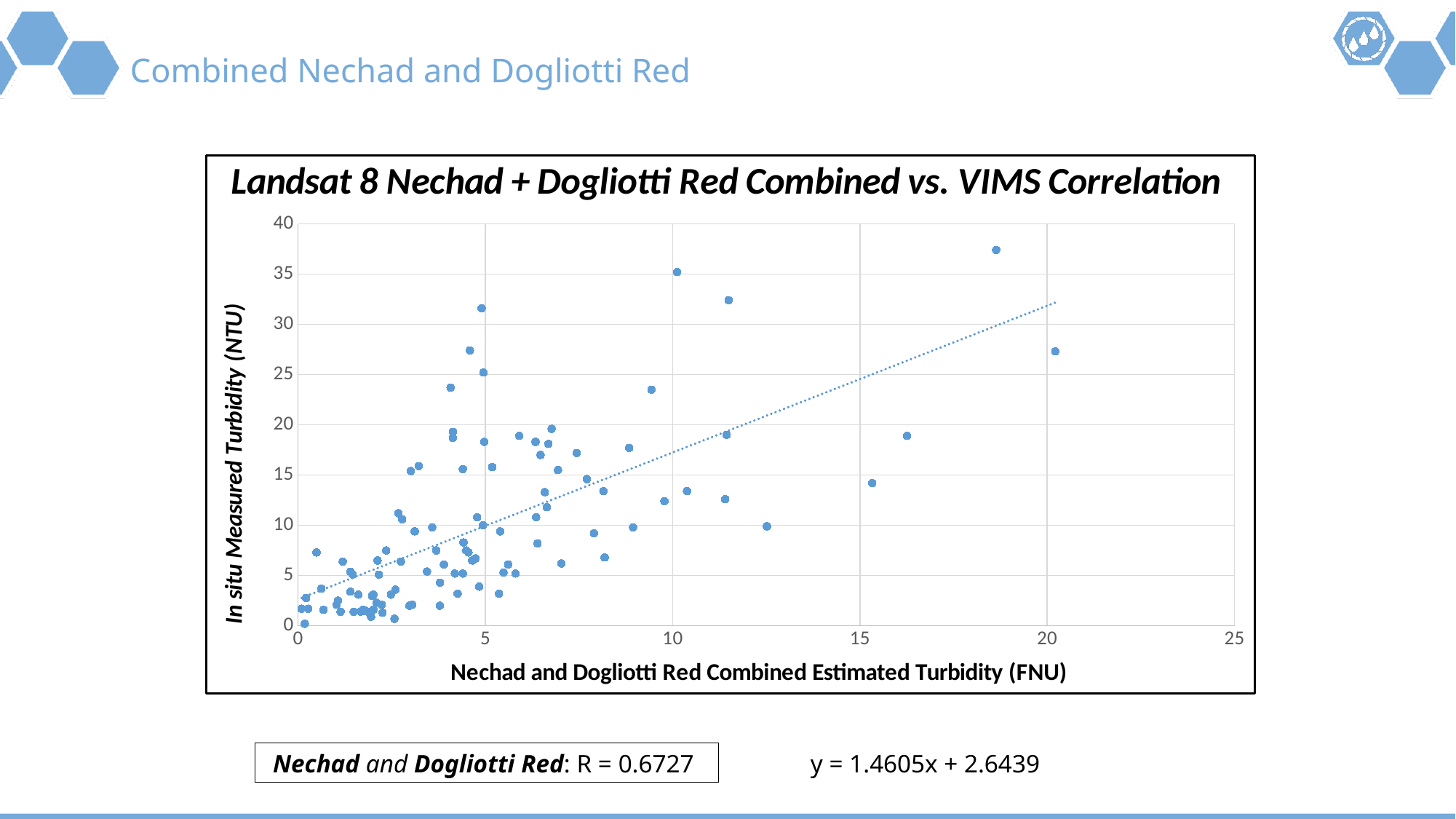
What is the maximum value shown on the y axis of the chart? 40 Does the dotted trend line slope upward or downward from left to right? Upward What is the title of the chart? Landsat 8 Nechad + Dogliotti Red Combined vs. VIMS Correlation Is the y value of the rightmost point on the chart greater or less than 25? greater Is the x value of the highest point on the chart greater or less than 15? greater What kind of chart is shown on the slide? Scatter plot Is the y value of the highest point on the chart greater or less than 35? greater Do the plotted values generally rise or fall as the x-axis value increases? Rise What is the label of the x axis of the chart? Nechad and Dogliotti Red Combined Estimated Turbidity (FNU)